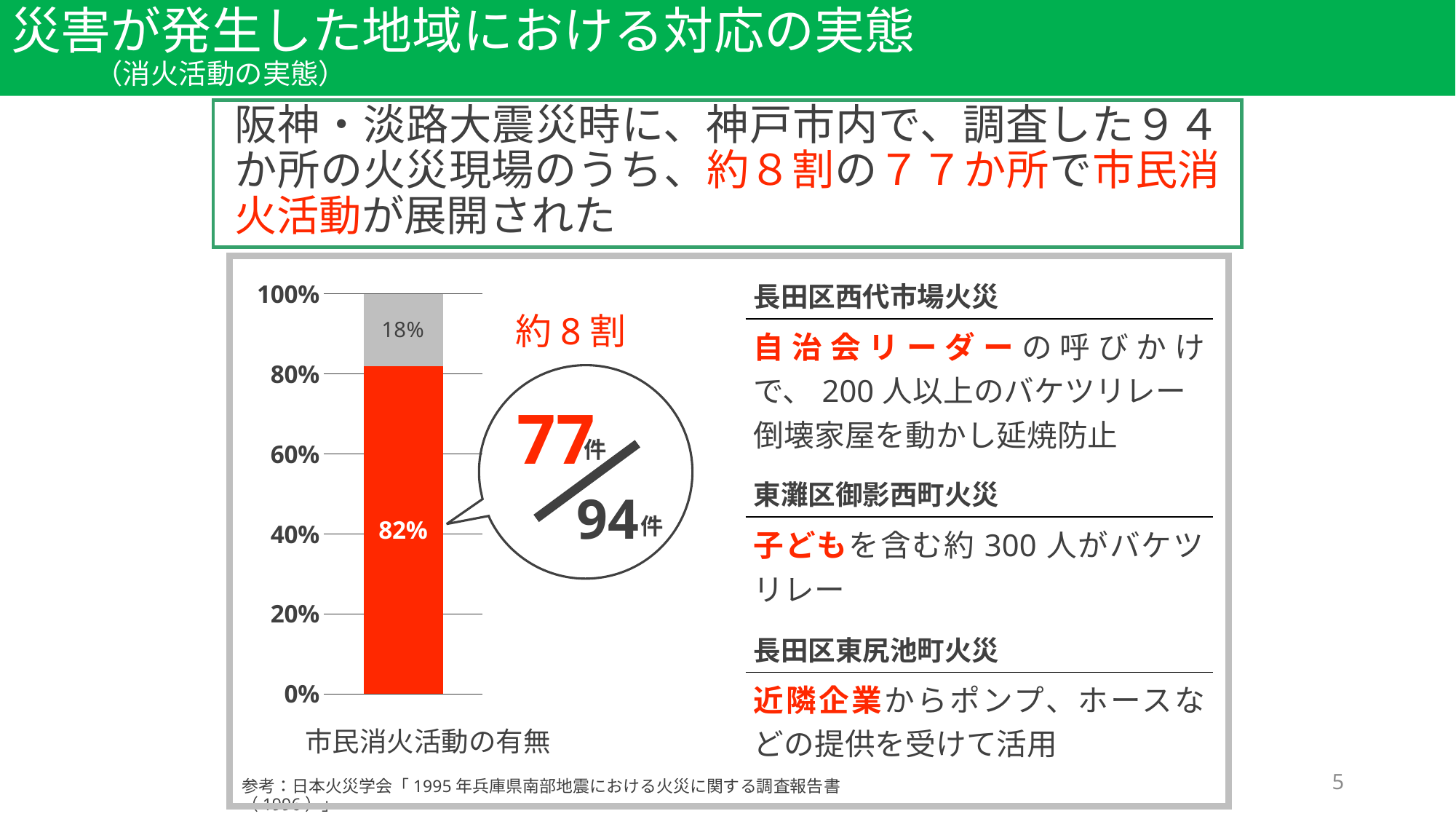
Which segment of the bar is larger, the red one or the gray one? the red one (82%) What is the difference between the red segment (82%) and the gray segment (18%)? 64% What kind of chart is shown on the slide? stacked bar chart According to the callout next to the bar, how many of the 94 cases had citizen firefighting activity? 77件 What is the total of the two segments of the stacked bar? 100% What is the highest value shown on the vertical axis? 100% Is the value of the gray segment greater or less than 20%? less What is the category label shown below the bar? 市民消火活動の有無 How many bars are plotted in the chart? 1 Is the value of the red segment greater or less than 80%? greater What is the value of the red segment of the bar? 82% What is the value of the gray segment at the top of the bar? 18%